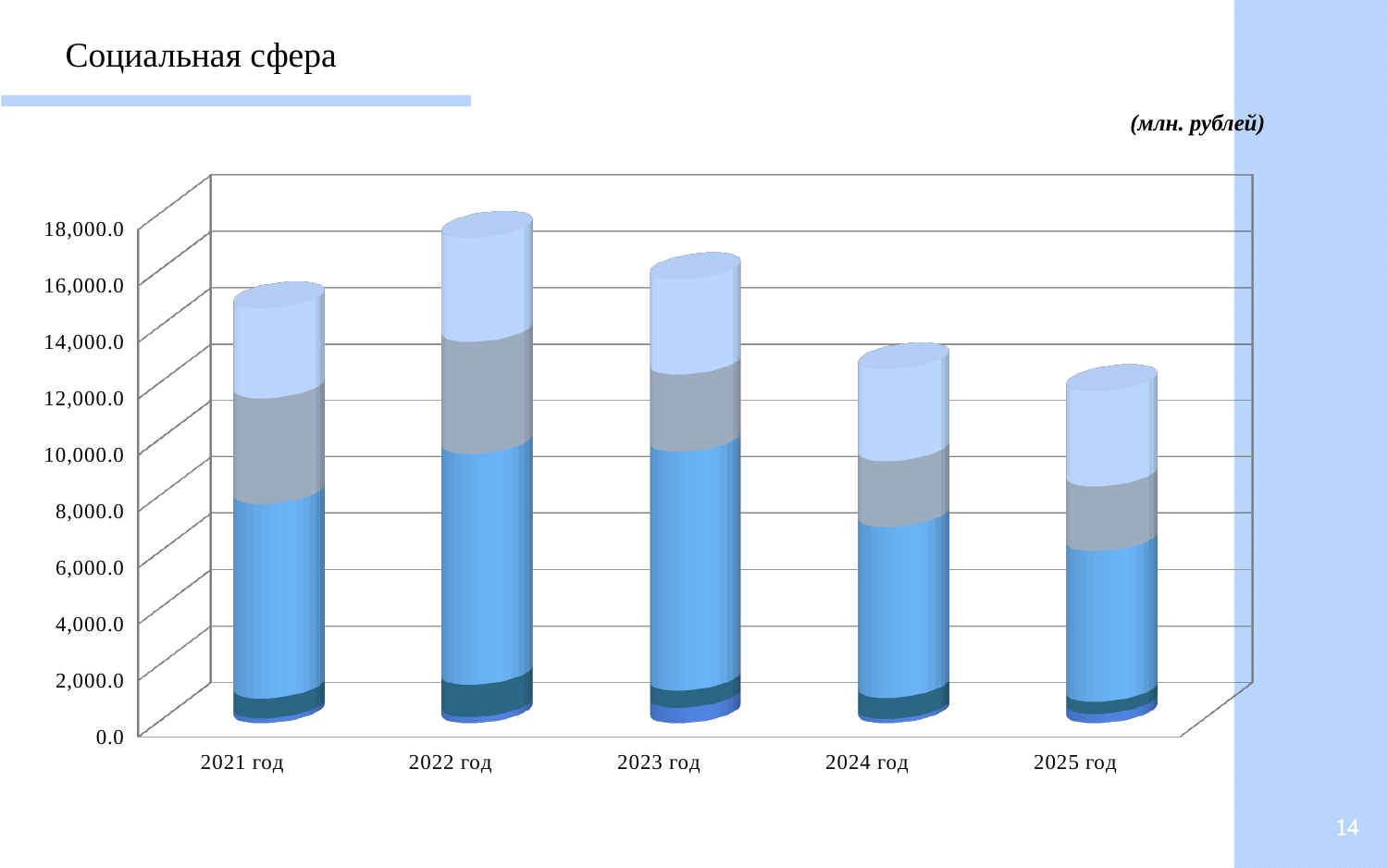
Which stacked bar is taller, 2021 год or 2024 год? 2021 год Which stacked bar is taller, 2023 год or 2025 год? 2023 год Is the total height of the 2022 год bar greater or less than 16,000.0? greater From 2022 год to 2025 год, do the total bar heights rise or fall? fall Is the total height of the 2021 год bar greater or less than 14,000.0? greater Is the total height of the 2025 год bar greater or less than 10,000.0? greater Which year has the tallest stacked bar in the chart? 2022 год What kind of chart is shown on the slide? stacked bar chart How many years (categories) are shown on the x axis of the chart? 5 What unit of measurement is indicated for the chart values? млн. рублей Which year has the shortest stacked bar in the chart? 2025 год